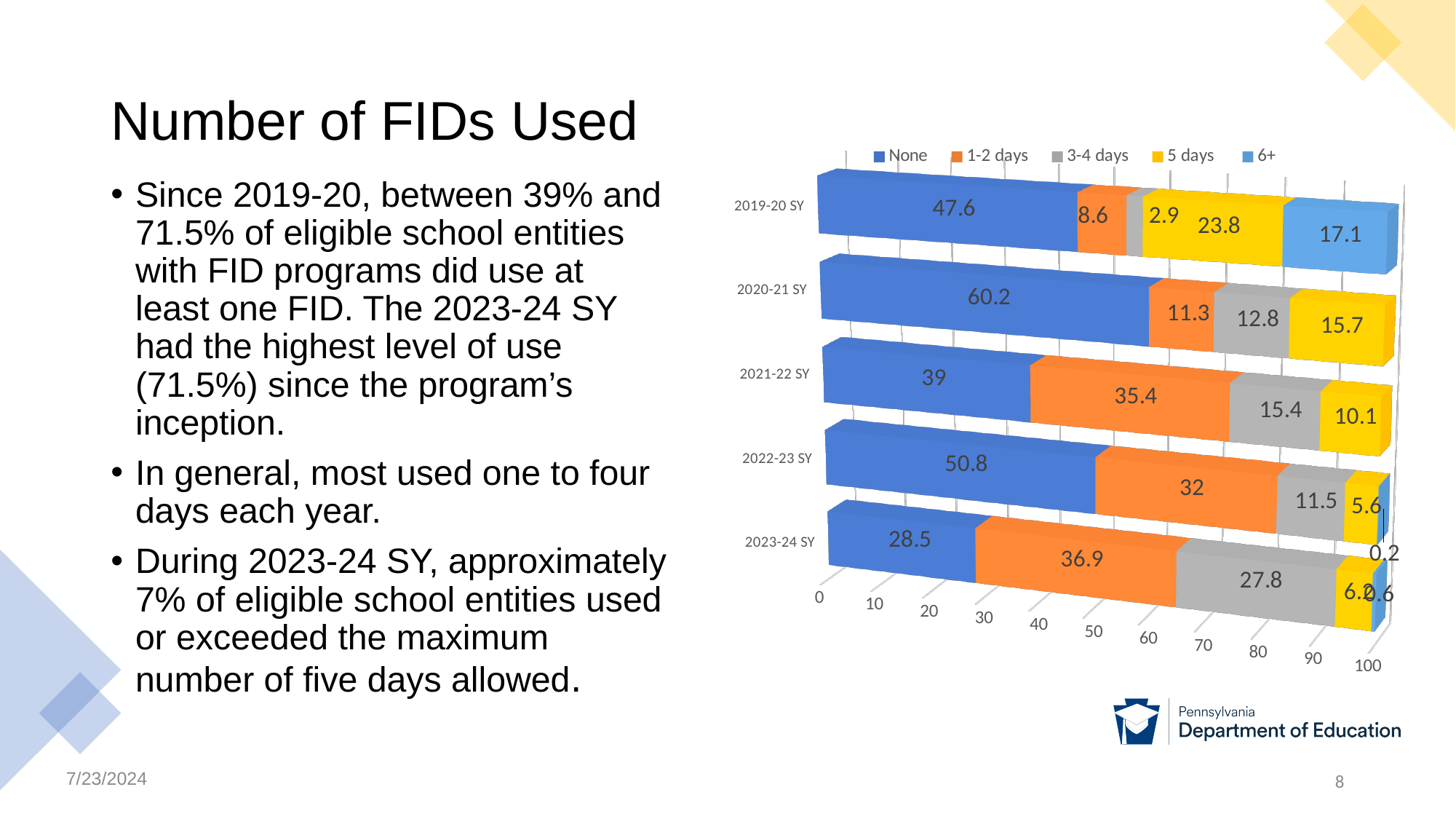
How many school years are shown on the chart? 5 What is the difference between the None value for 2020-21 SY and the None value for 2019-20 SY? 12.6 How many series does the legend list? 5 What is the value for 3-4 days in the 2023-24 SY? 27.8 What is the value for None in the 2019-20 SY? 47.6 What is the value for 1-2 days in the 2021-22 SY? 35.4 Which school year has the lowest value for None? 2023-24 SY Which school year has the highest value for None? 2020-21 SY Which school year has the larger value for 1-2 days, 2022-23 SY or 2023-24 SY? 2023-24 SY What is the value for 6+ in the 2019-20 SY? 17.1 What kind of chart is shown on the slide? Stacked bar chart What is the value for 5 days in the 2020-21 SY? 15.7